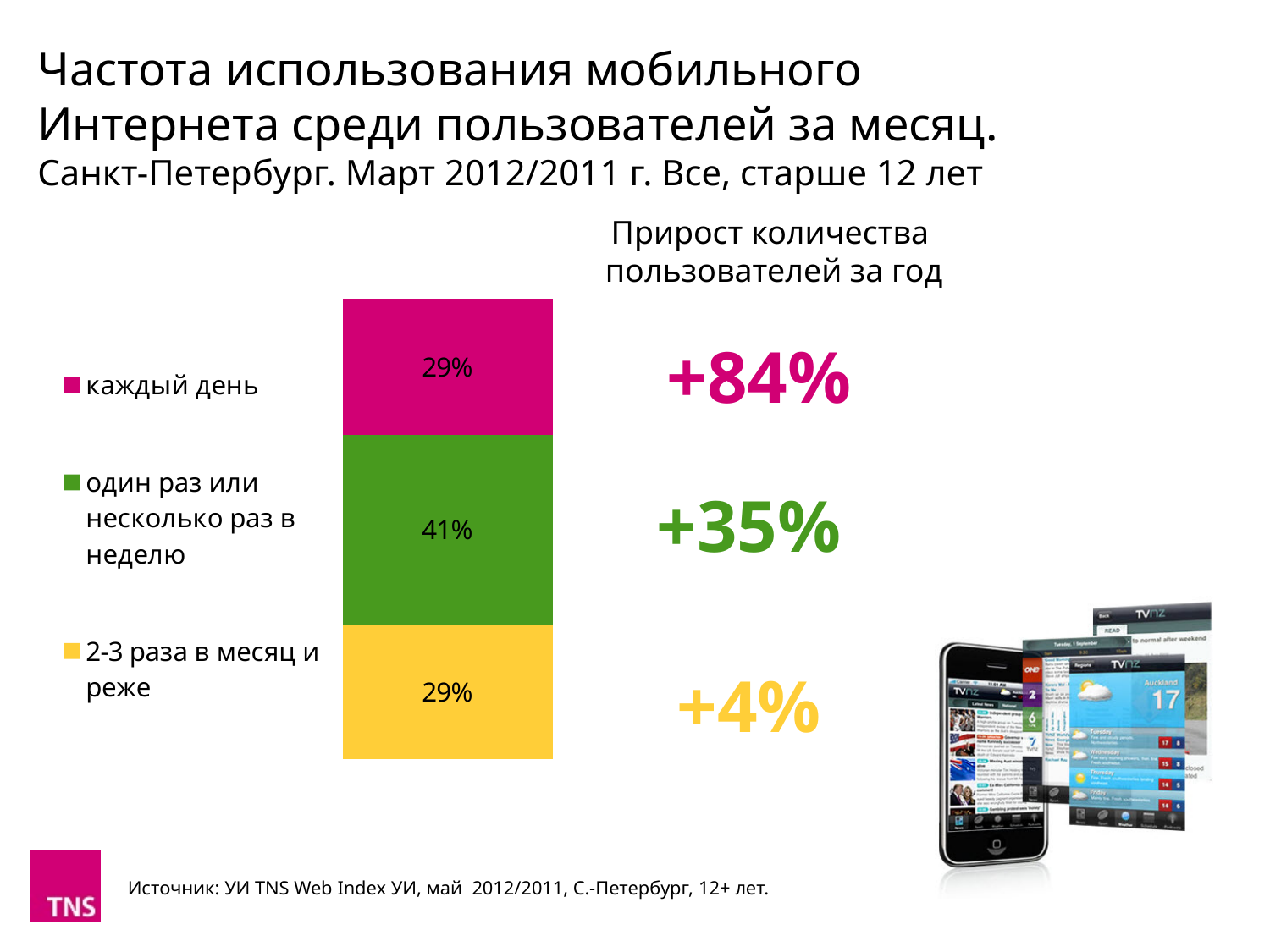
How many segments does the stacked bar contain? 3 What annual growth in the number of users is shown next to the 'каждый день' segment? +84% What is the total of the three labelled segments in the stacked bar? 99% Which is larger: the share for 'один раз или несколько раз в неделю' or the share for 'каждый день'? один раз или несколько раз в неделю What share of users use mobile Internet 2-3 times a month or less often (2-3 раза в месяц и реже)? 29% Which frequency group has the largest share in the stacked bar? один раз или несколько раз в неделю How many entries does the legend list? 3 What share of users use mobile Internet once or several times a week (один раз или несколько раз в неделю)? 41% What is the difference in percentage points between the 'один раз или несколько раз в неделю' share and the 'каждый день' share? 12 What kind of chart is shown on the slide? stacked bar chart What colour is the segment for 'каждый день'? magenta (pink) What share of users use mobile Internet every day (каждый день)? 29%